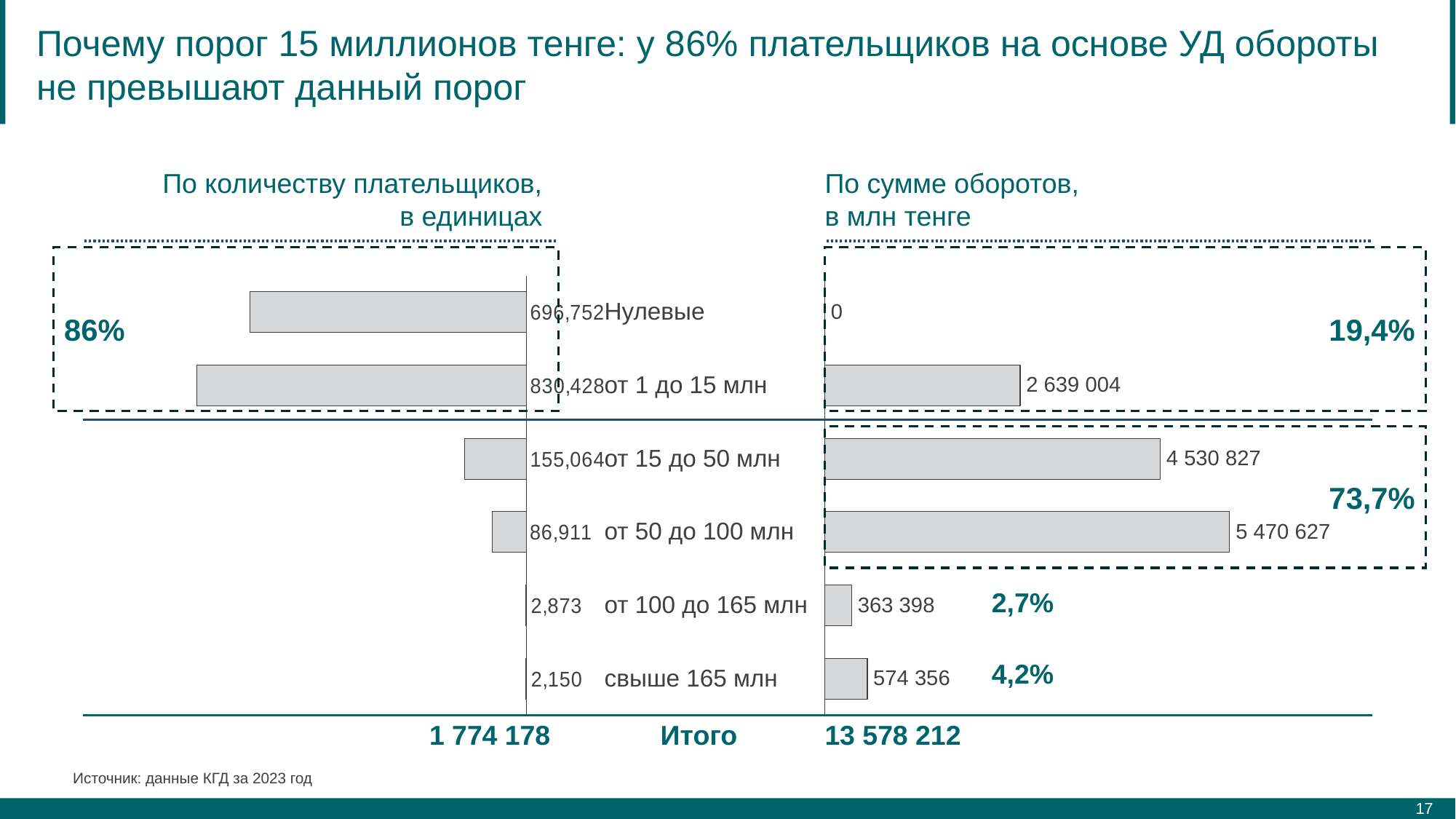
In the chart 'По количеству плательщиков, в единицах', which category has the highest value? от 1 до 15 млн In the chart 'По сумме оборотов, в млн тенге', what is the difference between 'от 50 до 100 млн' and 'от 15 до 50 млн'? 939 800 How many categories are shown in the chart 'По количеству плательщиков, в единицах'? 6 In the chart 'По сумме оборотов, в млн тенге', which is larger: 'от 100 до 165 млн' or 'свыше 165 млн'? свыше 165 млн What is the total ('Итого') shown for the chart 'По сумме оборотов, в млн тенге'? 13 578 212 In the chart 'По количеству плательщиков, в единицах', which category has the lowest value? свыше 165 млн What type of chart is 'По сумме оборотов, в млн тенге'? bar chart In the chart 'По сумме оборотов, в млн тенге', what is the value for 'Нулевые'? 0 In the chart 'По сумме оборотов, в млн тенге', what is the value for 'от 50 до 100 млн'? 5 470 627 In the chart 'По сумме оборотов, в млн тенге', which category has the highest value? от 50 до 100 млн In the chart 'По количеству плательщиков, в единицах', which is larger: 'Нулевые' or 'от 15 до 50 млн'? Нулевые In the chart 'По количеству плательщиков, в единицах', what is the value for 'от 1 до 15 млн'? 830,428